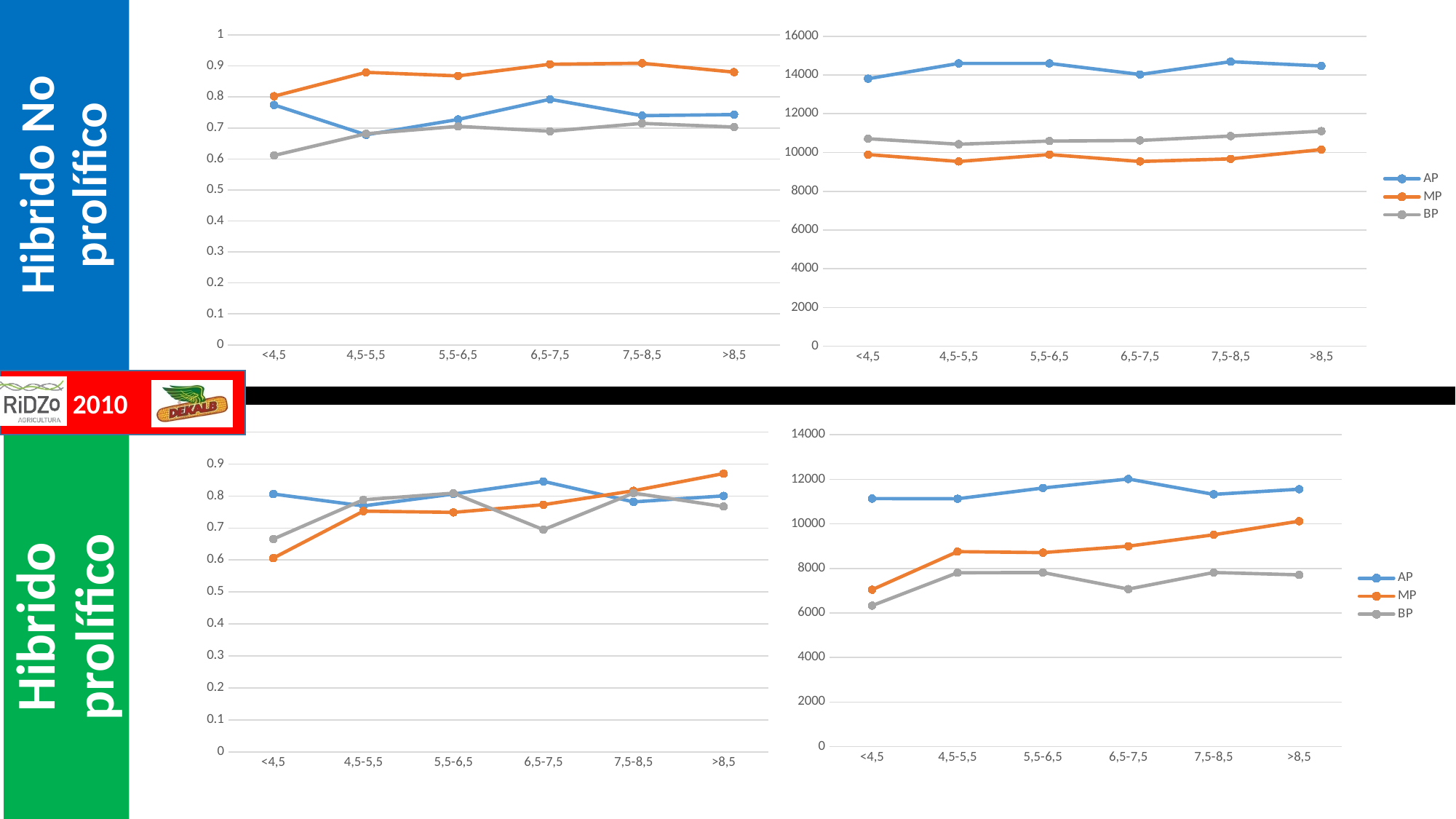
How many categories are shown on the x axis of the bottom-right chart (next to 'Hibrido prolífico')? 6 How many charts are shown on the slide? 4 In the bottom-right chart, does the MP series rise or fall from <4,5 to >8,5? rise In the top-right chart, which series has the highest values across all categories? AP In the top-right chart, which is larger at >8,5: AP or MP? AP In the bottom-right chart, is the value of AP at 6,5-7,5 greater or less than 10000? greater How many series does the legend of the top-right chart list? 3 In the top-right chart, is the value of MP at 4,5-5,5 greater or less than 10000? less What type of chart is the top-right chart on the slide (next to 'Hibrido No prolífico')? line chart In the top-right chart, is the value of AP at <4,5 greater or less than 12000? greater In the bottom-right chart, which series has the lowest values across all categories? BP